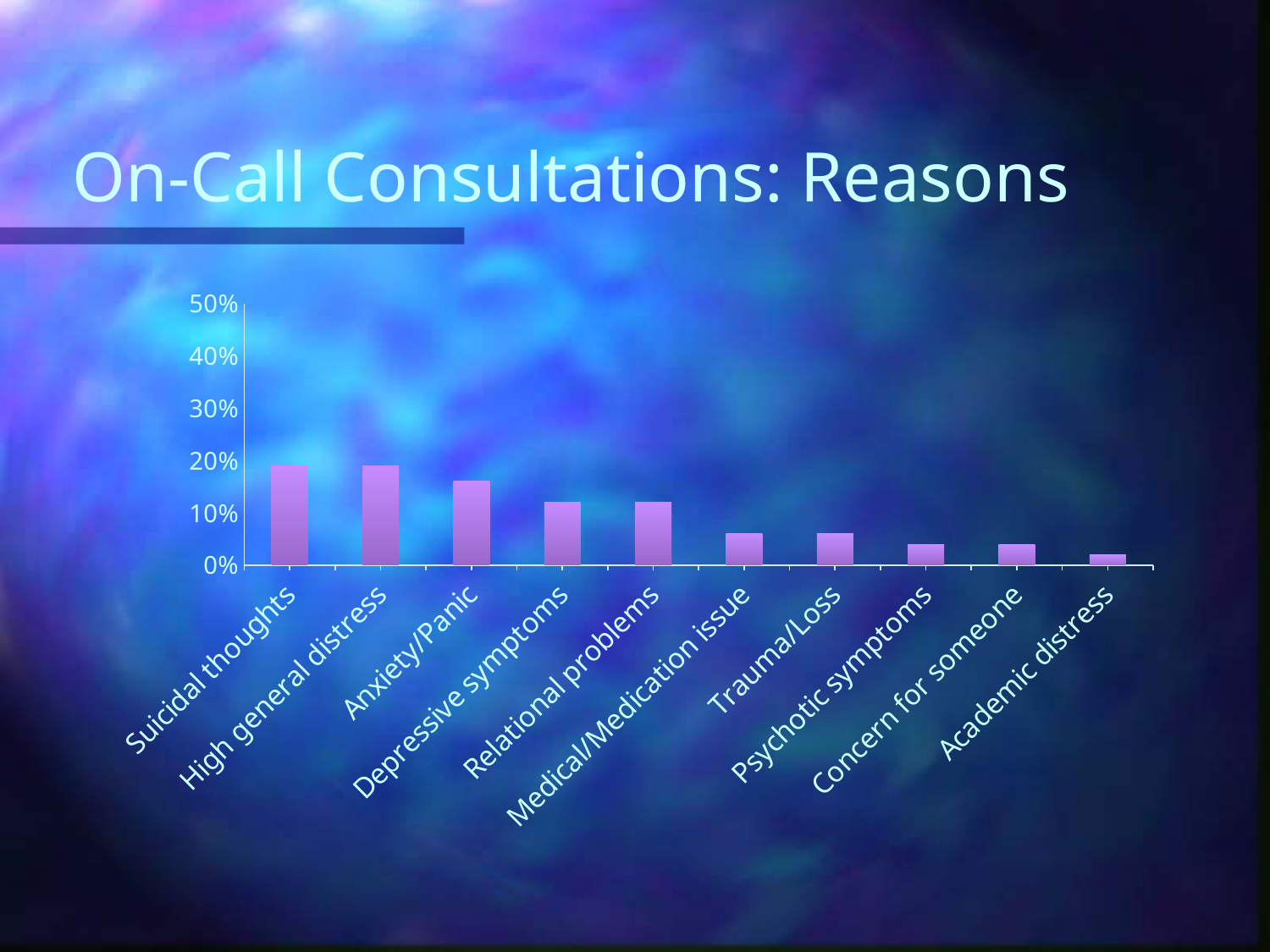
How many categories are shown on the x axis of the chart? 10 Is the value for High general distress greater or less than 30%? less Is the value for Anxiety/Panic greater or less than 20%? less Is the value for Trauma/Loss greater or less than 10%? less What kind of chart is shown on the slide? bar chart Which is larger, the value for Relational problems or the value for Psychotic symptoms? Relational problems Which is larger, the value for Anxiety/Panic or the value for Depressive symptoms? Anxiety/Panic Which category has the lowest value in the chart? Academic distress What is the title of the slide containing the chart? On-Call Consultations: Reasons Do the values generally rise or fall moving from left to right along the x axis? fall